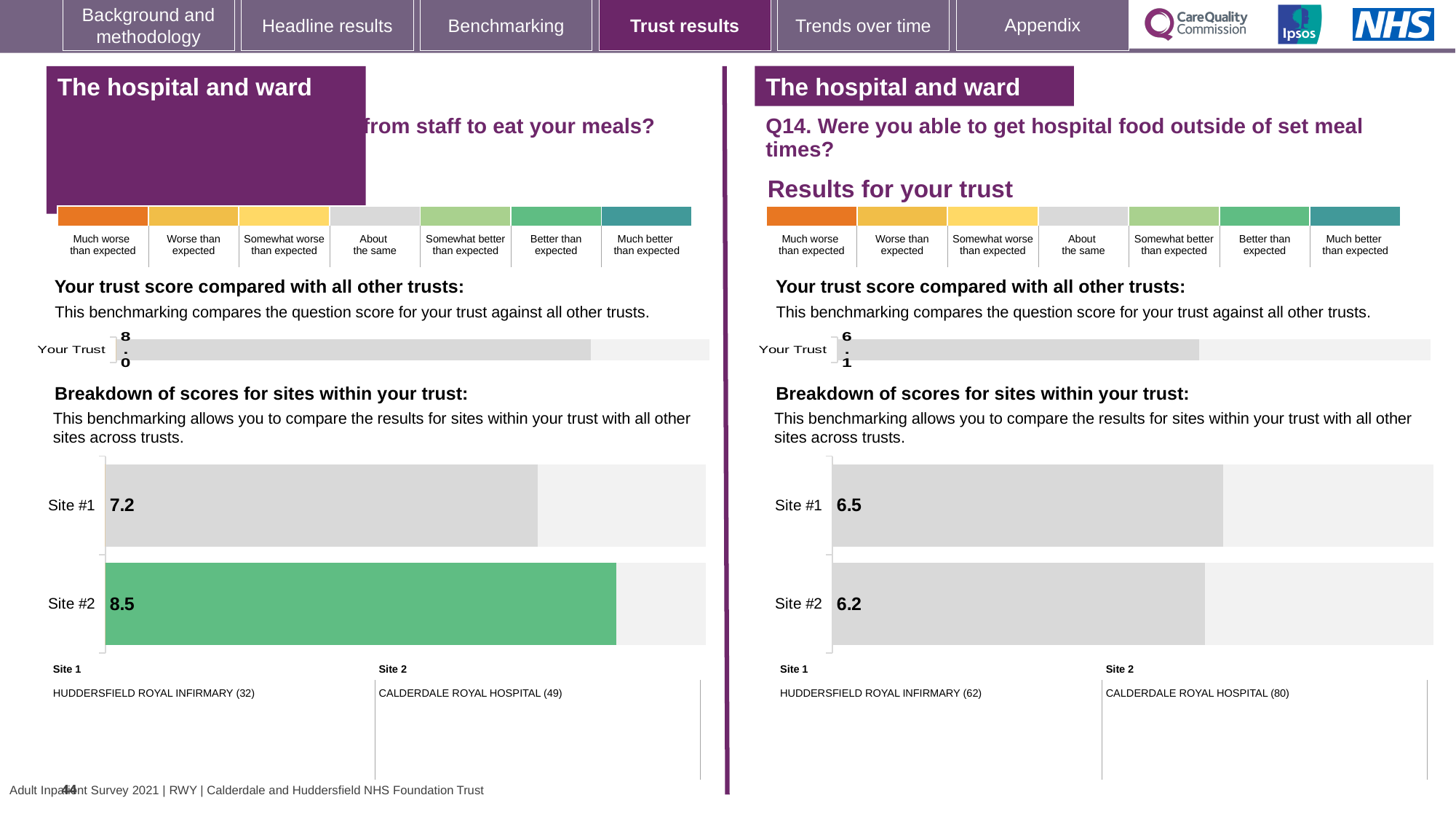
For Q14 (hospital food outside of set meal times), what is the score for Site #1 in the site breakdown chart? 6.5 On the left-hand side of the slide, which site's bar is coloured green in the site breakdown chart? Site #2 How many sites are shown in the Q14 site breakdown chart? 2 On the left-hand side of the slide, which site has the higher score in the site breakdown chart? Site #2 For Q14 (hospital food outside of set meal times), which site has the lower score in the site breakdown chart? Site #2 On the left-hand side of the slide, what is the difference between the Site #2 and Site #1 scores in the site breakdown chart? 1.3 On the left-hand side of the slide, what is the 'Your Trust' score in the trust score comparison chart? 8.0 On the left-hand side of the slide, what is the score for Site #1 in the breakdown of scores for sites within your trust? 7.2 On the left-hand side of the slide, what is the score for Site #2 in the breakdown of scores for sites within your trust? 8.5 For Q14 (hospital food outside of set meal times), what is the score for Site #2 in the site breakdown chart? 6.2 For Q14 (hospital food outside of set meal times), what is the difference between the Site #1 and Site #2 scores in the site breakdown chart? 0.3 For Q14 (hospital food outside of set meal times), what is the 'Your Trust' score in the trust score comparison chart? 6.1